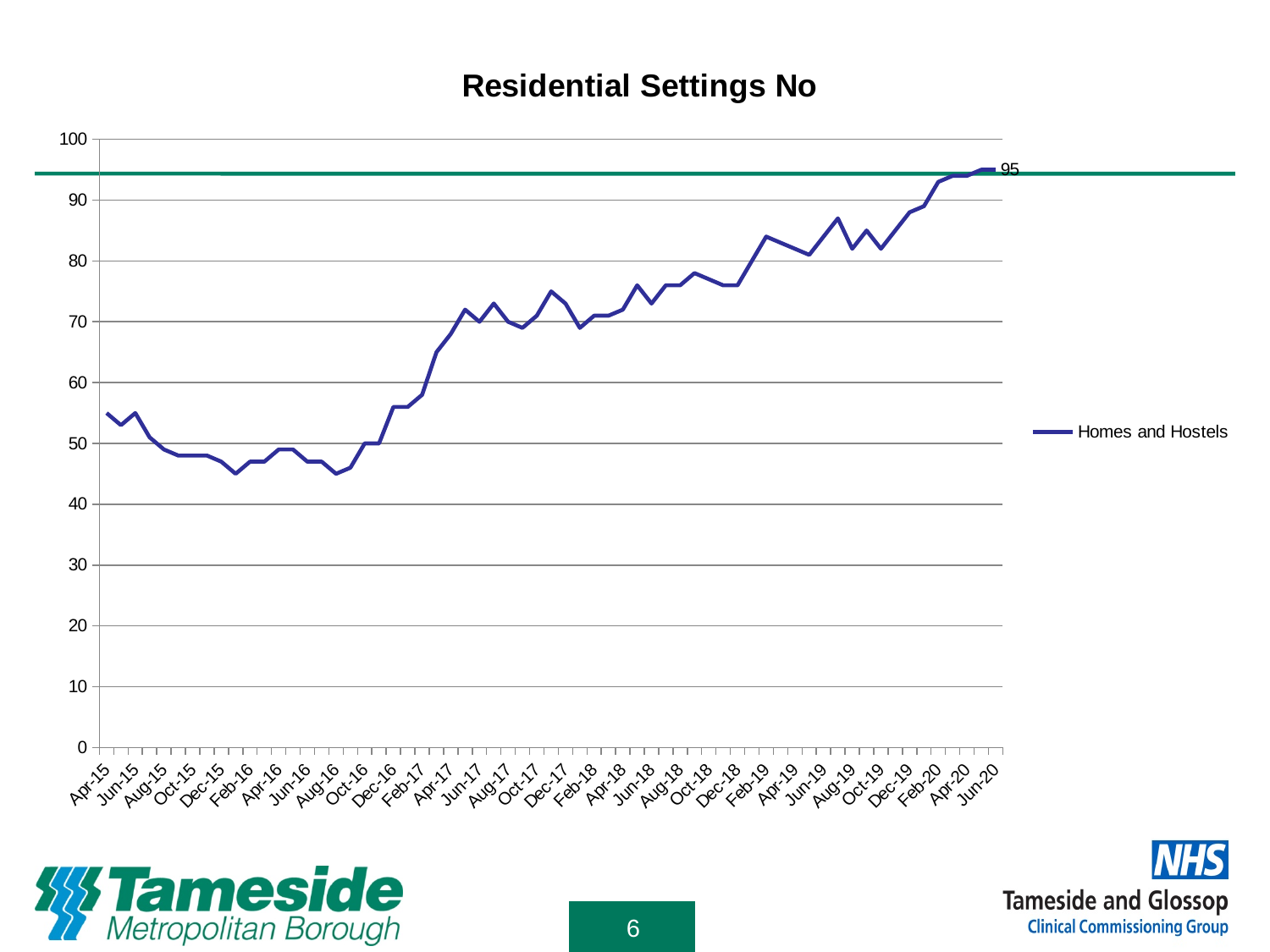
Is the value for Homes and Hostels at Apr-20 greater or less than 90? greater Overall, does the Homes and Hostels line rise or fall from Apr-15 to Jun-20? rise What is the name of the series shown in the legend? Homes and Hostels How many series does the legend list? 1 Is the value for Homes and Hostels at Apr-15 greater or less than 50? greater Is the value for Homes and Hostels at Feb-16 greater or less than 50? less Which is larger, the value for Homes and Hostels at Feb-16 or at Feb-19? Feb-19 At which month does the Homes and Hostels line reach its highest value? May-20 and Jun-20 What is the title of the chart? Residential Settings No What is the value for Homes and Hostels at Jun-20? 95 What kind of chart is shown on the slide? line chart